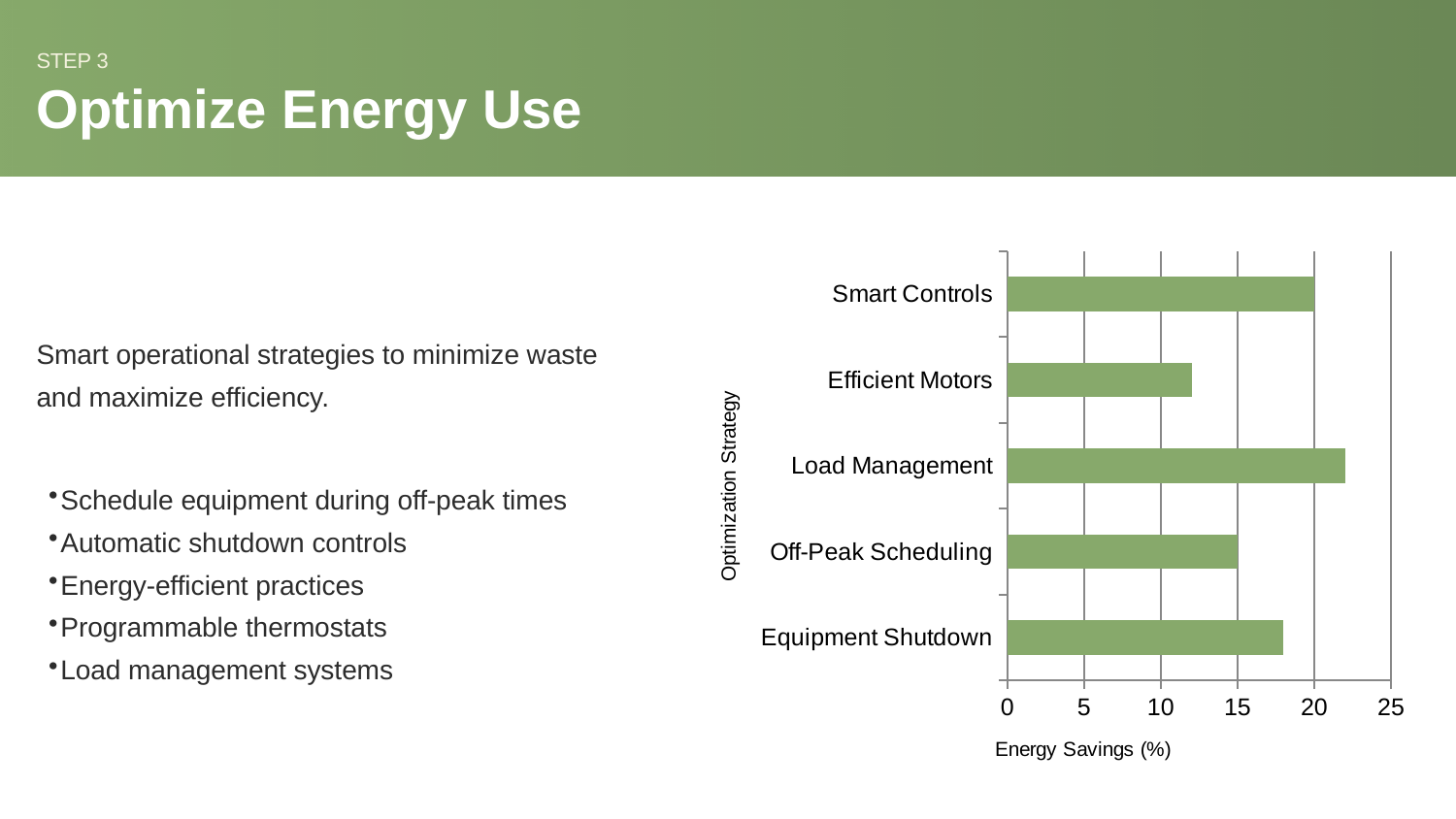
Is the value for Equipment Shutdown greater or less than 15? greater What is the label of the horizontal axis of the chart? Energy Savings (%) Which has higher energy savings, Smart Controls or Efficient Motors? Smart Controls What is the energy savings value for Off-Peak Scheduling? 15 What kind of chart is shown on the slide? bar chart Is the value for Efficient Motors greater or less than 15? less What is the label of the vertical axis of the chart? Optimization Strategy Which optimization strategy has the lowest energy savings? Efficient Motors How many optimization strategies are plotted in the chart? 5 Which optimization strategy has the highest energy savings? Load Management What is the energy savings value for Smart Controls? 20 Is the value for Load Management greater or less than 20? greater